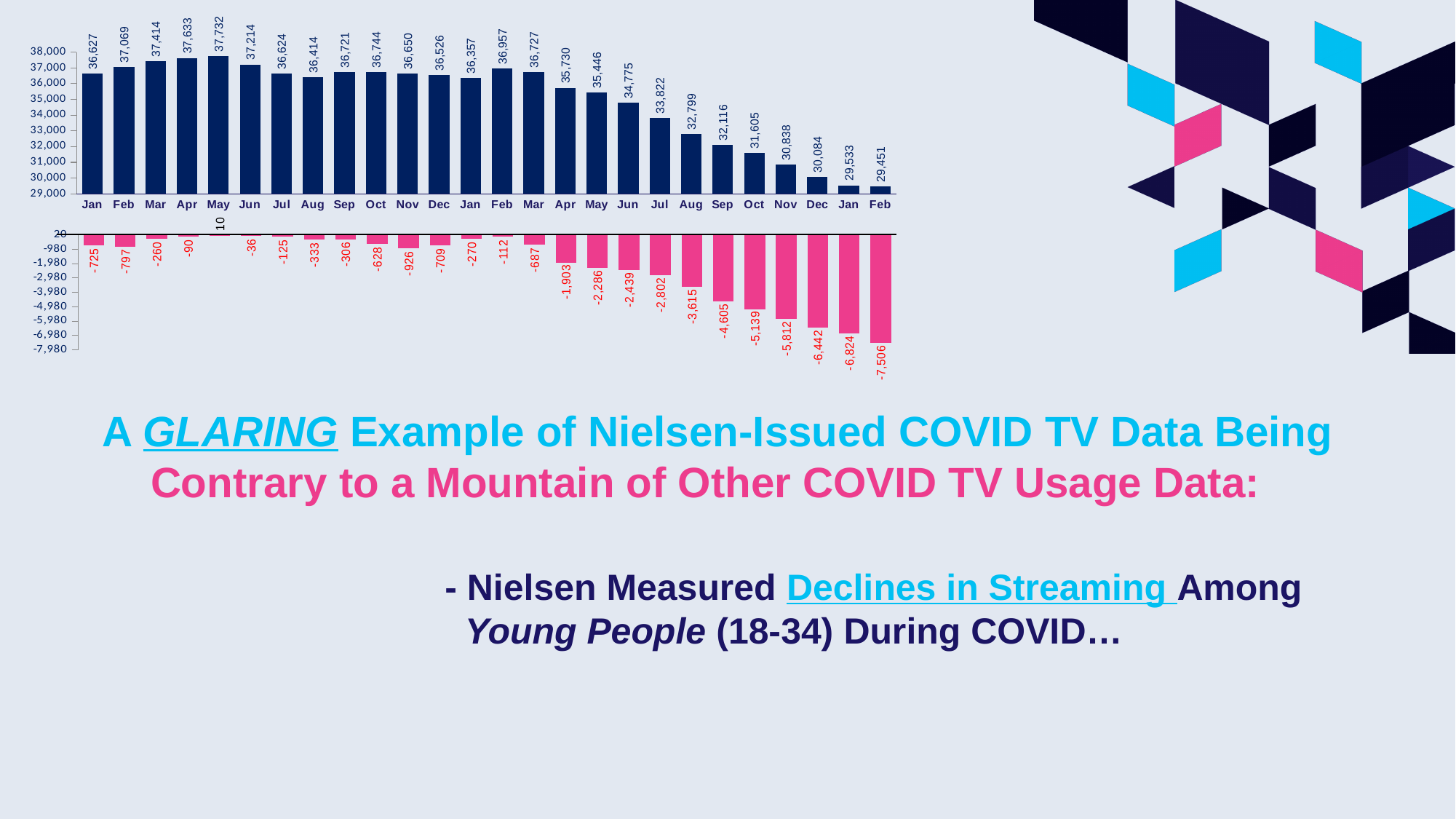
What kind of chart is the top chart? Bar chart In the bottom chart, what is the value for the second Aug bar? -3,615 In the top chart, which month has the highest value? May (first year), 37,732 In the bottom chart, which month is the only one with a positive value, and what is it? May (first year), 10 In the top chart, do the values rise or fall from the second Mar bar to the final Feb bar? Fall In the top chart, what is the difference between the first Jan bar (36,627) and the last Jan bar (29,533)? 7,094 In the top chart, which month has the lowest value? Feb (last bar), 29,451 In the top chart, what is the value for the first Jan bar? 36,627 In the top chart, which is larger: the first Feb bar or the second Feb bar? The first Feb bar (37,069) How many bars are plotted in the top chart? 26 In the top chart, what is the value for the last Dec bar? 30,084 In the bottom chart, which month has the lowest (most negative) value? Feb (last bar), -7,506